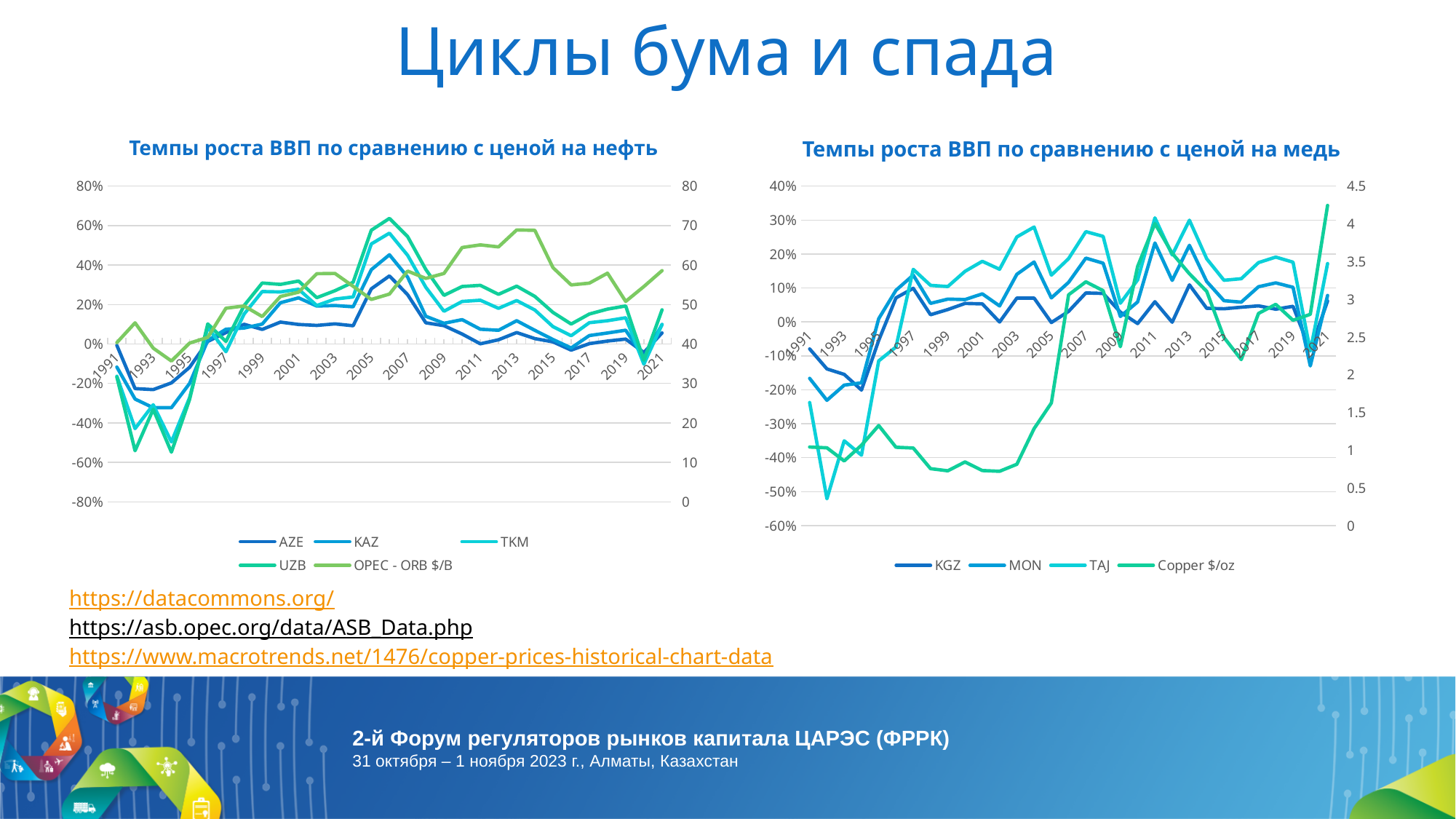
In the right chart ('Темпы роста ВВП по сравнению с ценой на медь'), which series has the lowest value in 1992? TAJ In the left chart ('Темпы роста ВВП по сравнению с ценой на нефть'), is the UZB value in 1992 greater or less than -40%? less In the right chart ('Темпы роста ВВП по сравнению с ценой на медь'), which series is labelled in $/oz in the legend? Copper $/oz In the right chart ('Темпы роста ВВП по сравнению с ценой на медь'), is the Copper $/oz value in 2021 greater or less than 4? greater In the left chart ('Темпы роста ВВП по сравнению с ценой на нефть'), which series is plotted against the right-hand axis in $/B? OPEC - ORB $/B What kind of chart is the left chart, 'Темпы роста ВВП по сравнению с ценой на нефть'? Line chart In the left chart ('Темпы роста ВВП по сравнению с ценой на нефть'), is the OPEC - ORB $/B value in 2013 greater or less than 60? greater How many series does the legend of the left chart ('Темпы роста ВВП по сравнению с ценой на нефть') list? 5 In the right chart ('Темпы роста ВВП по сравнению с ценой на медь'), does the Copper $/oz line rise or fall between 2005 and 2007? Rises In the left chart ('Темпы роста ВВП по сравнению с ценой на нефть'), does the OPEC - ORB $/B line rise or fall between 2013 and 2016? Falls How many series does the legend of the right chart ('Темпы роста ВВП по сравнению с ценой на медь') list? 4